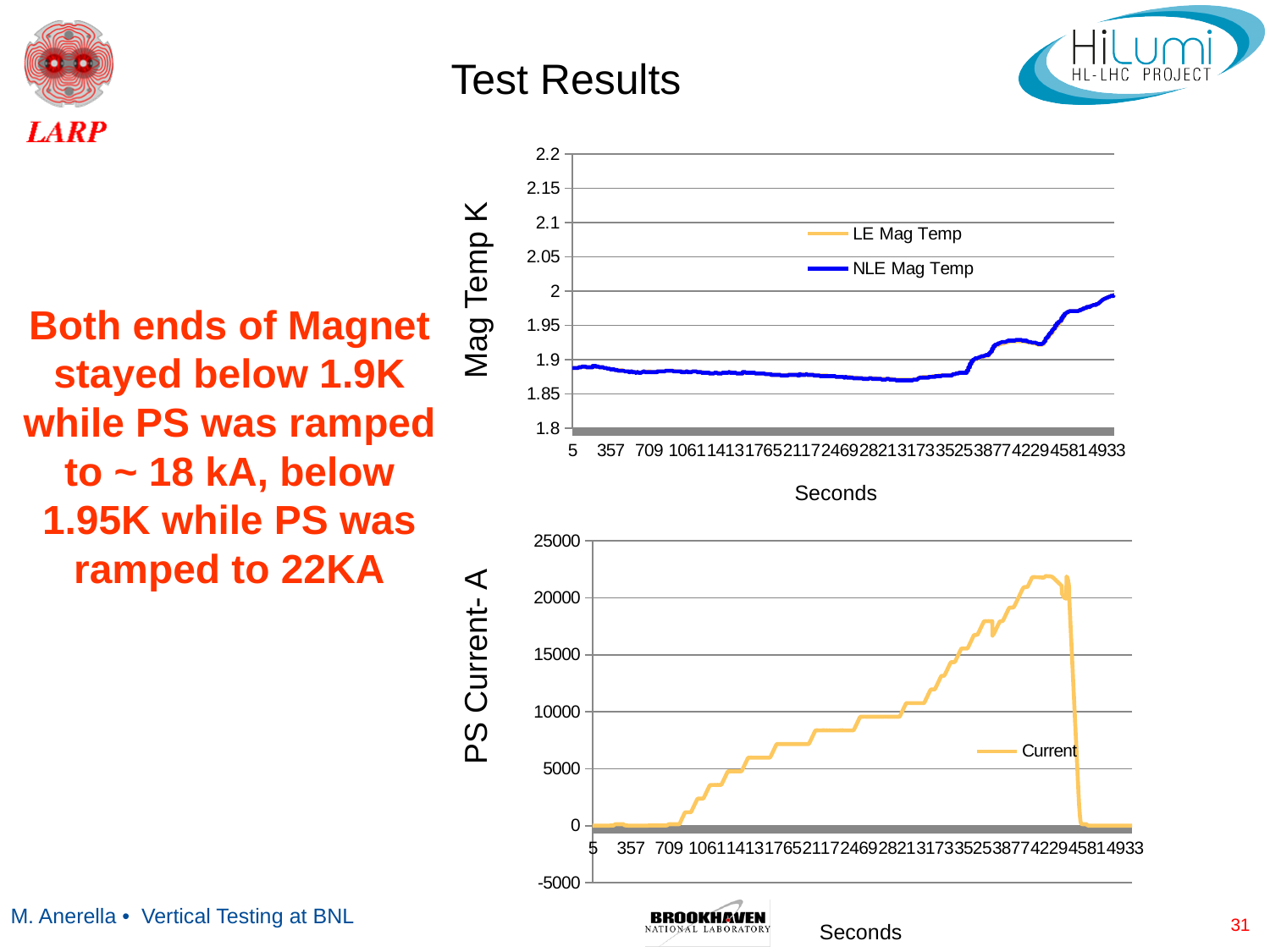
In the bottom chart, is the Current value at the start of the x axis greater or less than 5000? less In the top chart, what are the two series named in the legend? LE Mag Temp and NLE Mag Temp What is the y-axis label of the bottom chart? PS Current- A What kind of chart is the top chart on the slide? line chart In the top chart, is the NLE Mag Temp value at the far right of the x axis greater or less than 2.05? less In the bottom chart, is the peak value of the Current series greater or less than 20000? greater In the bottom chart, does the Current series generally rise or fall from the start of the x axis up to its peak? rise What kind of chart is the bottom chart on the slide? line chart In the top chart, does the NLE Mag Temp series rise or fall over the last portion of the x axis? rise How many series does the legend of the bottom chart list? 1 How many series does the legend of the top chart list? 2